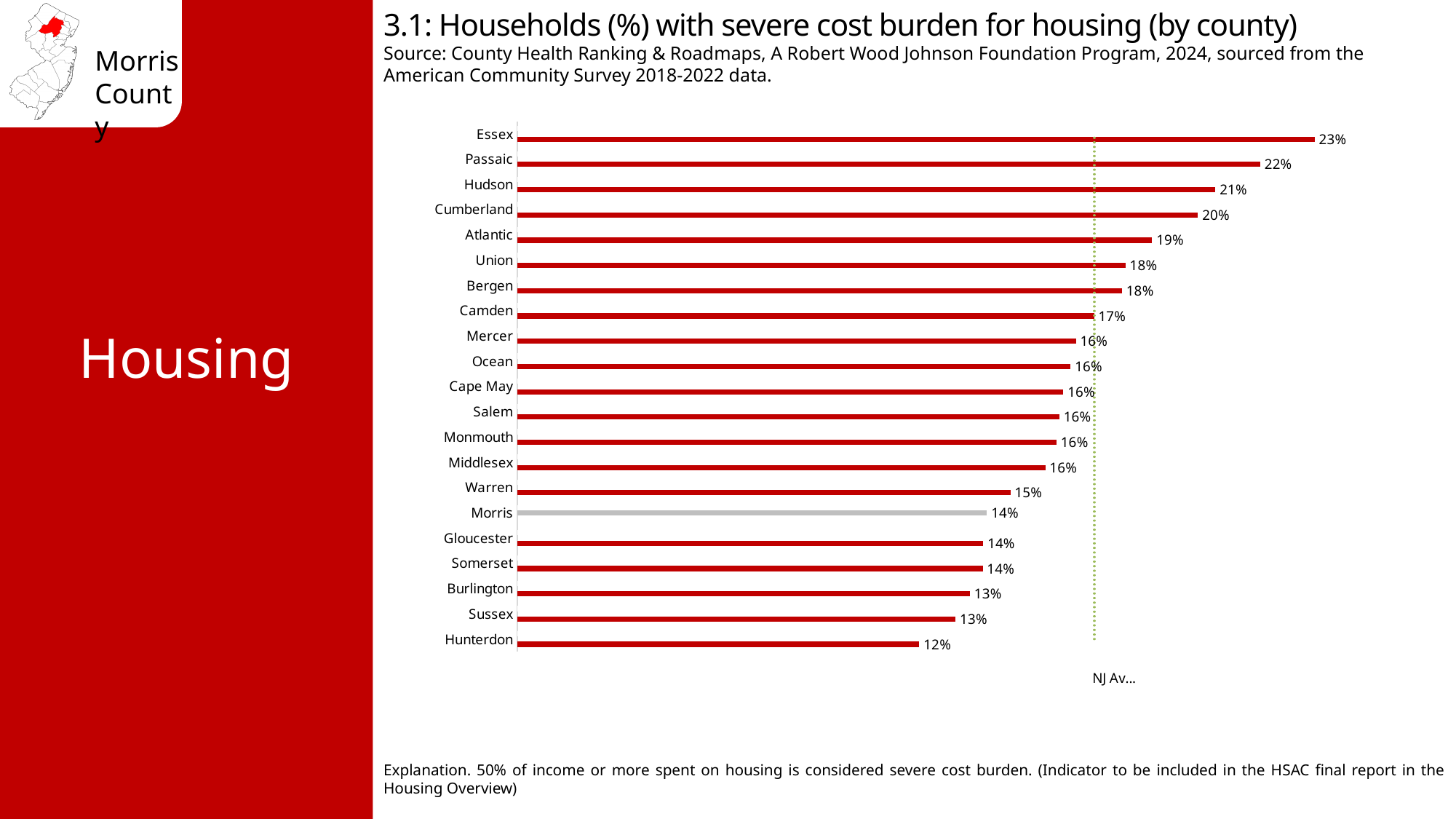
What is the value for Essex County? 23% What is the value for Atlantic County? 19% What kind of chart is shown on the slide? Bar chart What is the difference between the values for Essex and Morris? 9% Which county's bar is shown in grey instead of red? Morris How many counties are shown in the chart? 21 What is the value for Morris County? 14% What is the difference between the values for Hudson and Sussex? 8% Which county has the highest percentage of households with severe cost burden for housing? Essex Which county has the lowest percentage of households with severe cost burden for housing? Hunterdon What is the value for Hunterdon County? 12% Which has a higher value, Passaic or Cumberland? Passaic